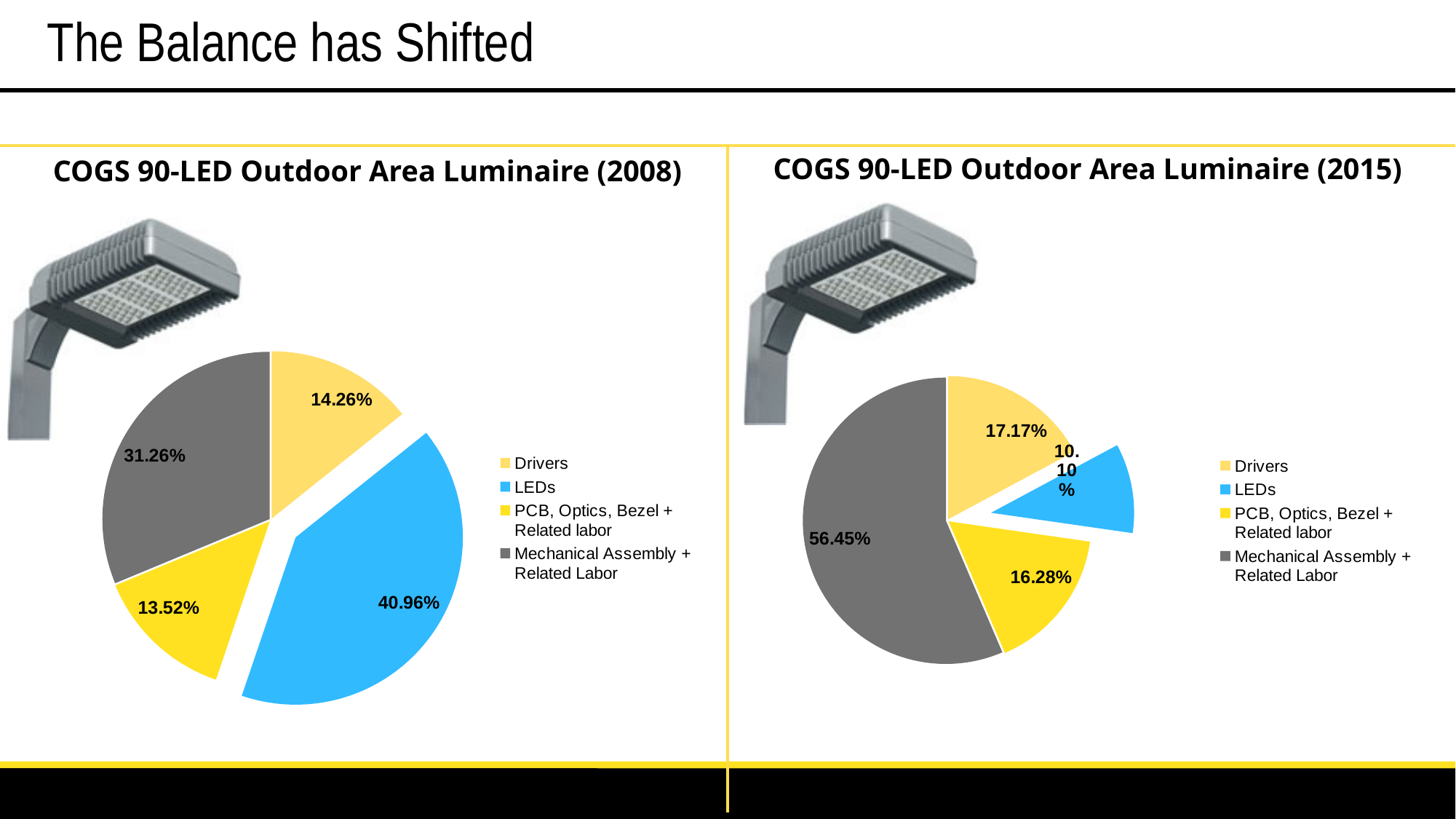
In the COGS 90-LED Outdoor Area Luminaire (2008) chart, which category has the largest slice? LEDs In the COGS 90-LED Outdoor Area Luminaire (2015) chart, which category has the smallest slice? LEDs What type of chart is used on the left side of the slide for the 2008 data? Pie chart In the COGS 90-LED Outdoor Area Luminaire (2008) chart, which category has the smallest slice? PCB, Optics, Bezel + Related labor In the COGS 90-LED Outdoor Area Luminaire (2015) chart, what is the value for Mechanical Assembly + Related Labor? 56.45% In the COGS 90-LED Outdoor Area Luminaire (2015) chart, what is the difference between Mechanical Assembly + Related Labor and Drivers? 39.28% In the COGS 90-LED Outdoor Area Luminaire (2008) chart, what share do LEDs account for? 40.96% In the COGS 90-LED Outdoor Area Luminaire (2008) chart, what colour is the LEDs slice? Blue In the COGS 90-LED Outdoor Area Luminaire (2008) chart, what is the value for Mechanical Assembly + Related Labor? 31.26% How many categories does the legend of the COGS 90-LED Outdoor Area Luminaire (2015) chart list? 4 In the COGS 90-LED Outdoor Area Luminaire (2015) chart, what share do LEDs account for? 10.10% In the COGS 90-LED Outdoor Area Luminaire (2008) chart, which is larger: Drivers or PCB, Optics, Bezel + Related labor? Drivers